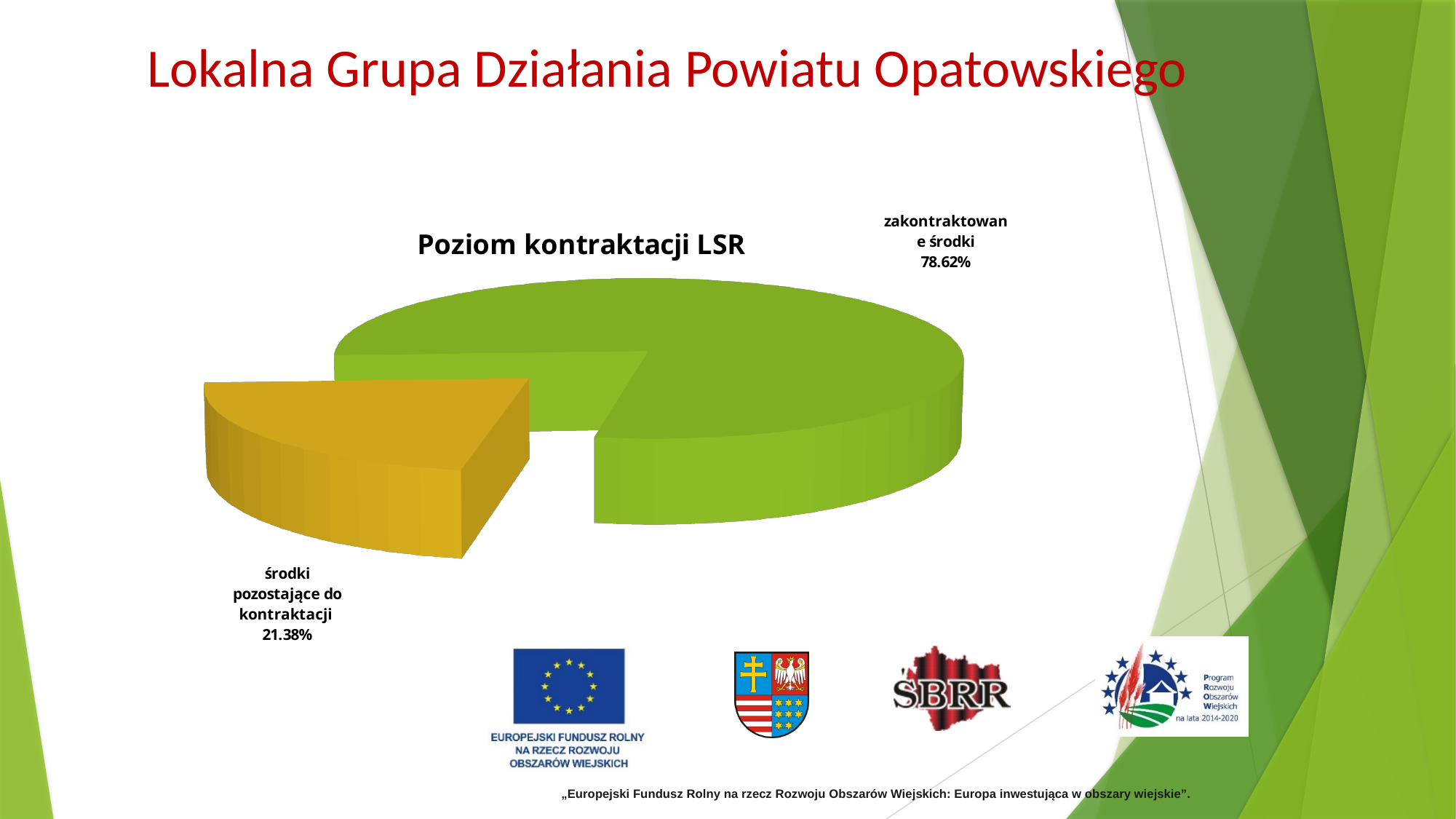
Which is larger: the share for "zakontraktowane środki" or the share for "środki pozostające do kontraktacji"? zakontraktowane środki What is the title of the chart? Poziom kontraktacji LSR What share of the pie is labelled "środki pozostające do kontraktacji"? 21.38% What is the difference in percentage points between the "zakontraktowane środki" slice and the "środki pozostające do kontraktacji" slice? 57.24 percentage points What type of chart is shown on the slide? Pie chart Is the share for "zakontraktowane środki" greater or less than 50%? greater How many slices does the pie chart have? 2 Which slice of the pie is the largest? zakontraktowane środki What colour is the slice representing "środki pozostające do kontraktacji"? Yellow Which slice of the pie is the smallest? środki pozostające do kontraktacji What share of the pie is labelled "zakontraktowane środki"? 78.62% Is the share for "środki pozostające do kontraktacji" greater or less than 25%? less